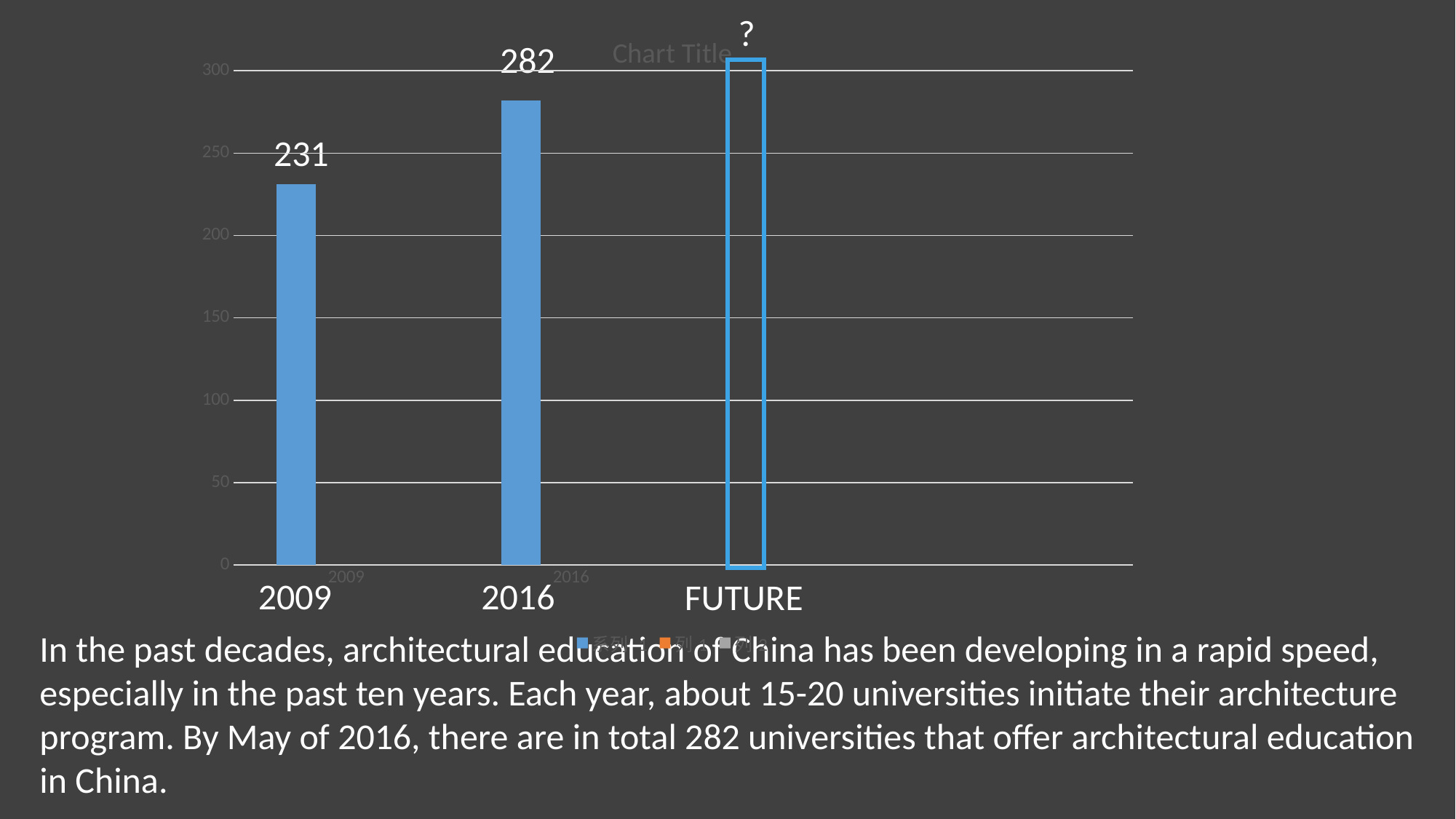
What label is printed above the FUTURE bar? ? Is the value for 2016 greater or less than 250? greater What is the title of the chart? Chart Title Does the value rise or fall from 2009 to 2016? rise How many categories are shown on the x axis? 3 Is the value for 2009 greater or less than 250? less What is the value shown for 2016? 282 What is the difference between the values for 2016 and 2009? 51 What kind of chart is shown on the slide? bar chart Which is larger, the value for 2009 or the value for 2016? 2016 What is the value shown for 2009? 231